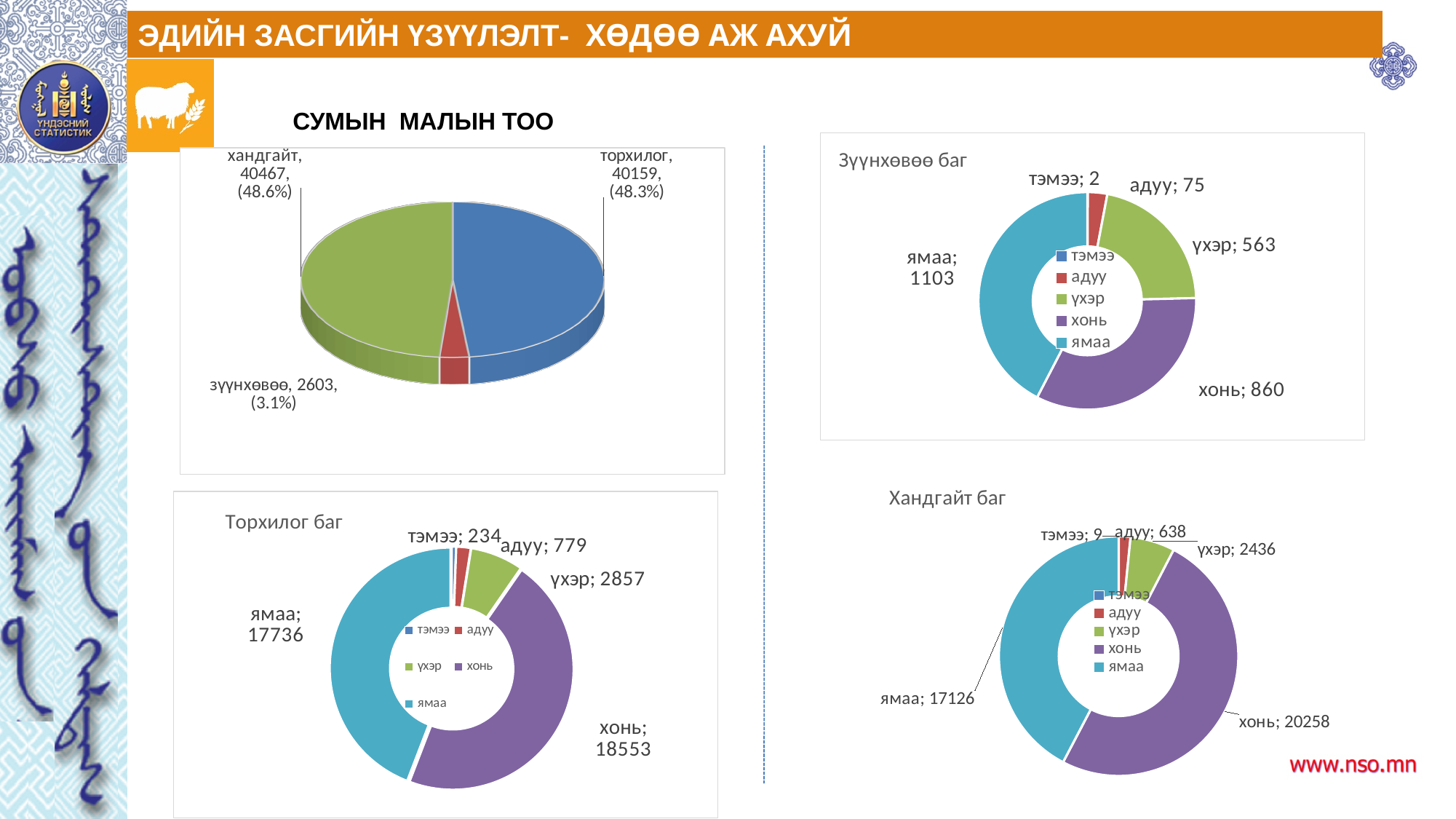
In the "СУМЫН МАЛЫН ТОО" pie chart, which slice is the largest? хандгайт In the "Хандгайт баг" chart, what is the value for үхэр? 2436 In the "СУМЫН МАЛЫН ТОО" pie chart, what value is shown for хандгайт? 40467 In the "СУМЫН МАЛЫН ТОО" pie chart, what share of the total does зүүнхөвөө have? 3.1% How many categories does the "Торхилог баг" chart show? 5 What type of chart is the "Хандгайт баг" chart? doughnut chart In the "Торхилог баг" chart, which is larger, хонь or ямаа? хонь In the "Зүүнхөвөө баг" chart, which category has the smallest value? тэмээ In the "Хандгайт баг" chart, what is the difference between хонь and ямаа? 3132 In the "Зүүнхөвөө баг" chart, what is the value for ямаа? 1103 In the "Зүүнхөвөө баг" chart, what is the difference between хонь and үхэр? 297 In the "Торхилог баг" chart, what is the value for хонь? 18553